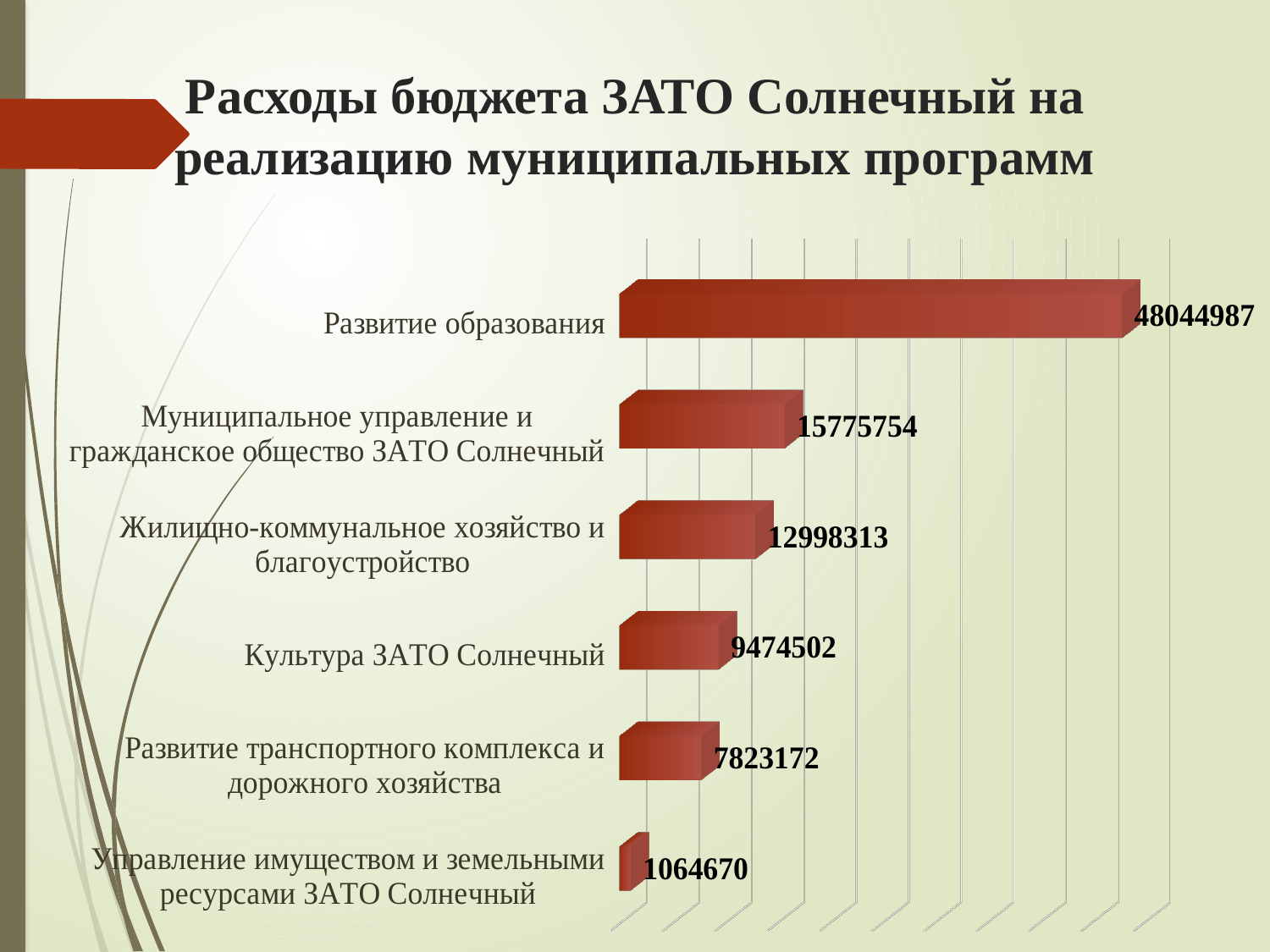
Which category has the highest value? Развитие образования What is the value for Управление имуществом и земельными ресурсами ЗАТО Солнечный? 1064670 What is the value for Жилищно-коммунальное хозяйство и благоустройство? 12998313 What is the title of the slide? Расходы бюджета ЗАТО Солнечный на реализацию муниципальных программ What is the value for Культура ЗАТО Солнечный? 9474502 What kind of chart is shown on the slide? Bar chart How many categories are shown in the chart? 6 What is the difference between the values for Развитие образования and Муниципальное управление и гражданское общество ЗАТО Солнечный? 32269233 Which is larger: the value for Жилищно-коммунальное хозяйство и благоустройство or the value for Культура ЗАТО Солнечный? Жилищно-коммунальное хозяйство и благоустройство What is the value for Развитие образования? 48044987 Which category has the lowest value? Управление имуществом и земельными ресурсами ЗАТО Солнечный What is the difference between the values for Культура ЗАТО Солнечный and Развитие транспортного комплекса и дорожного хозяйства? 1651330